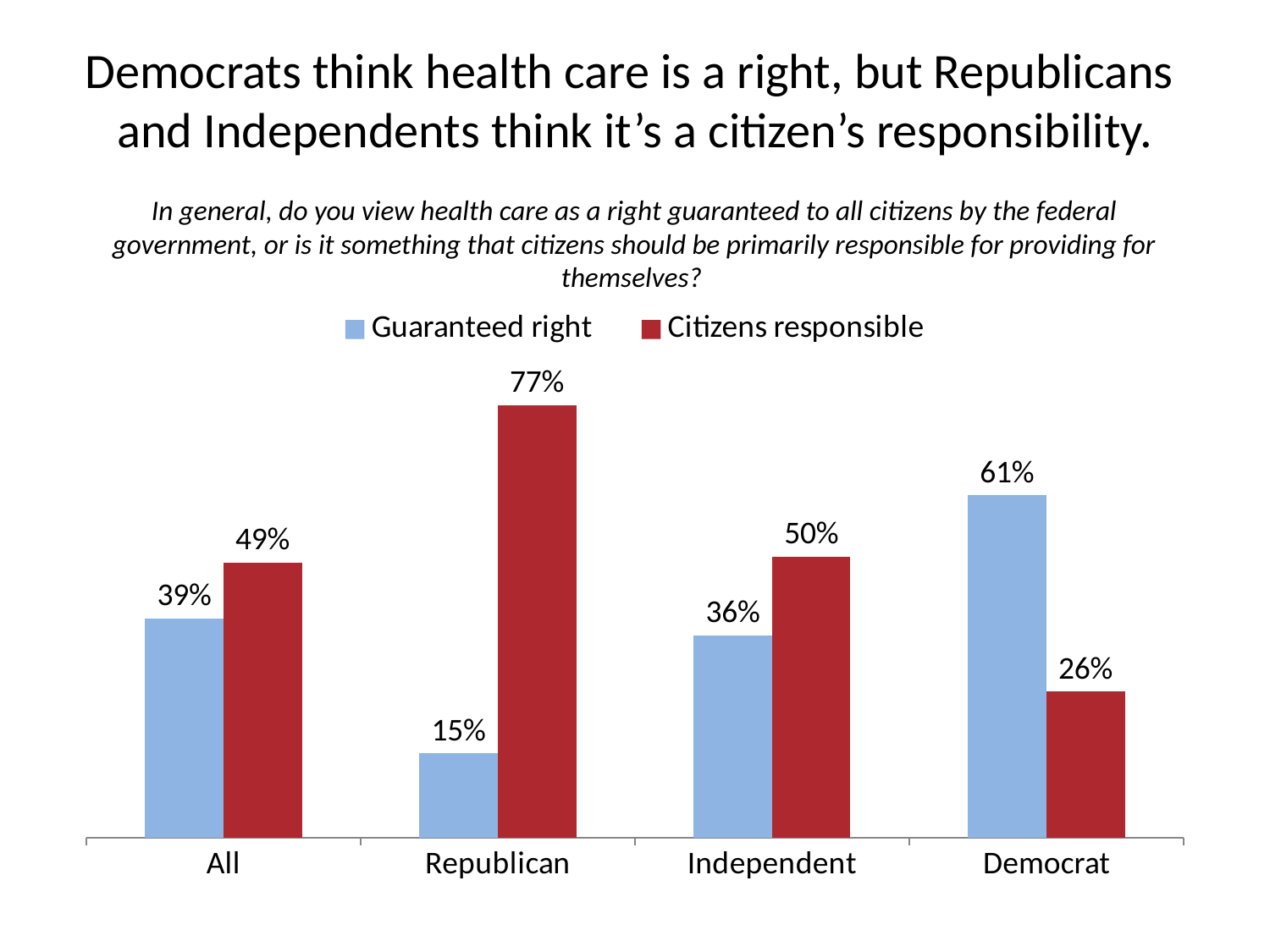
How many categories are shown on the x axis? 4 What percentage of Republicans say citizens are responsible for health care? 77% How many series does the legend list? 2 What percentage of Democrats view health care as a guaranteed right? 61% What is the 'Guaranteed right' value for Independents? 36% Which category has the lowest 'Guaranteed right' value? Republican What is the 'Citizens responsible' value for the 'All' category? 49% For Democrats, which is larger: 'Guaranteed right' or 'Citizens responsible'? Guaranteed right What is the difference between the 'Guaranteed right' value for Democrats and for Independents? 25 percentage points Which category has the highest 'Citizens responsible' value? Republican What is the difference between the 'Citizens responsible' and 'Guaranteed right' values for Republicans? 62 percentage points What kind of chart is shown on the slide? Bar chart